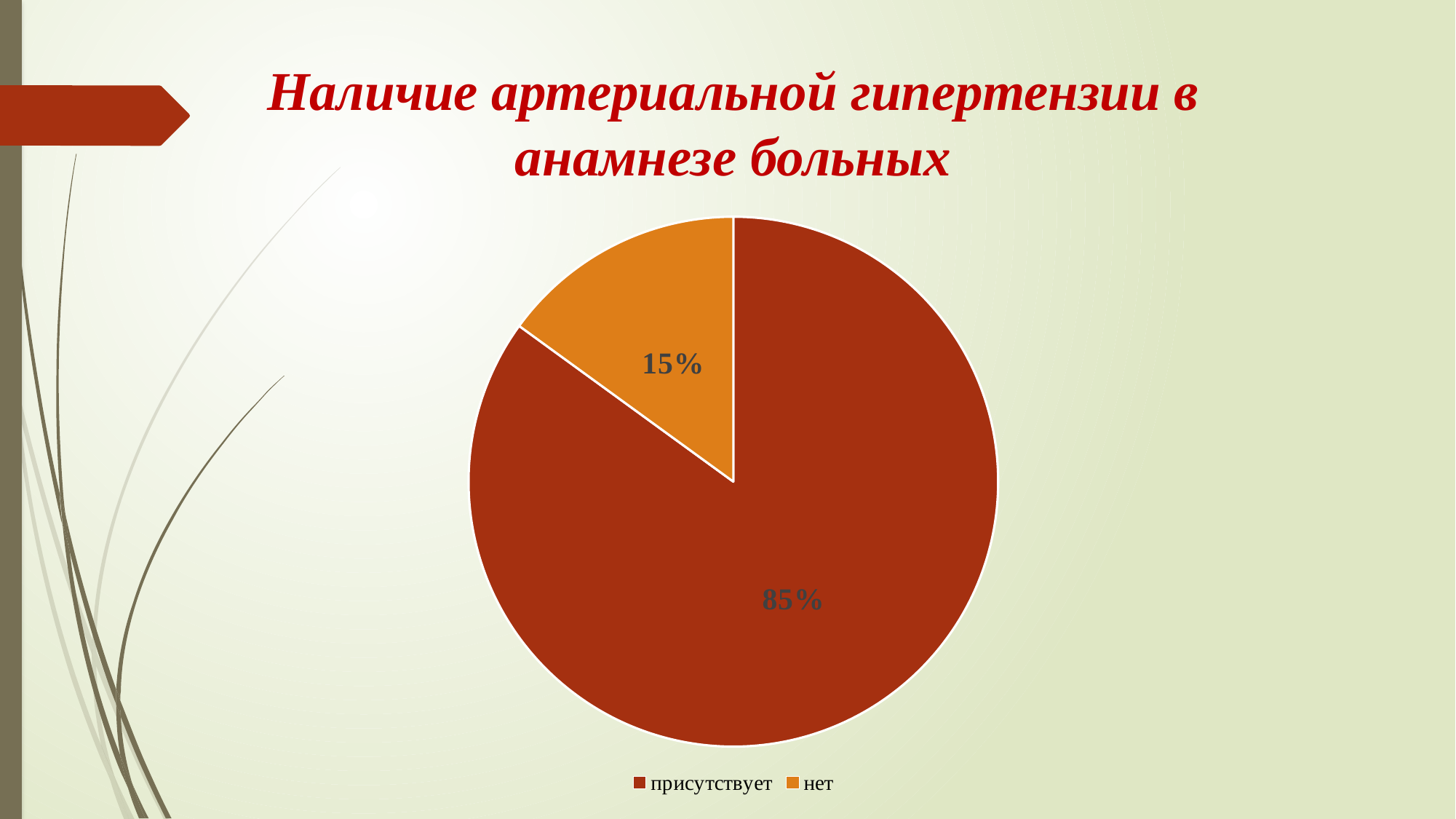
What share of the pie does the 'нет' slice represent? 15% Which slice is larger, 'присутствует' or 'нет'? присутствует Which category has the smallest slice of the pie? нет How many slices does the pie chart have? 2 How many entries does the legend list? 2 What is the title of the slide? Наличие артериальной гипертензии в анамнезе больных Which category has the largest slice of the pie? присутствует What colour is the 'нет' slice? orange What kind of chart is shown on the slide? pie chart What is the difference in percentage points between the 'присутствует' and 'нет' slices? 70 What share of the pie does the 'присутствует' slice represent? 85%